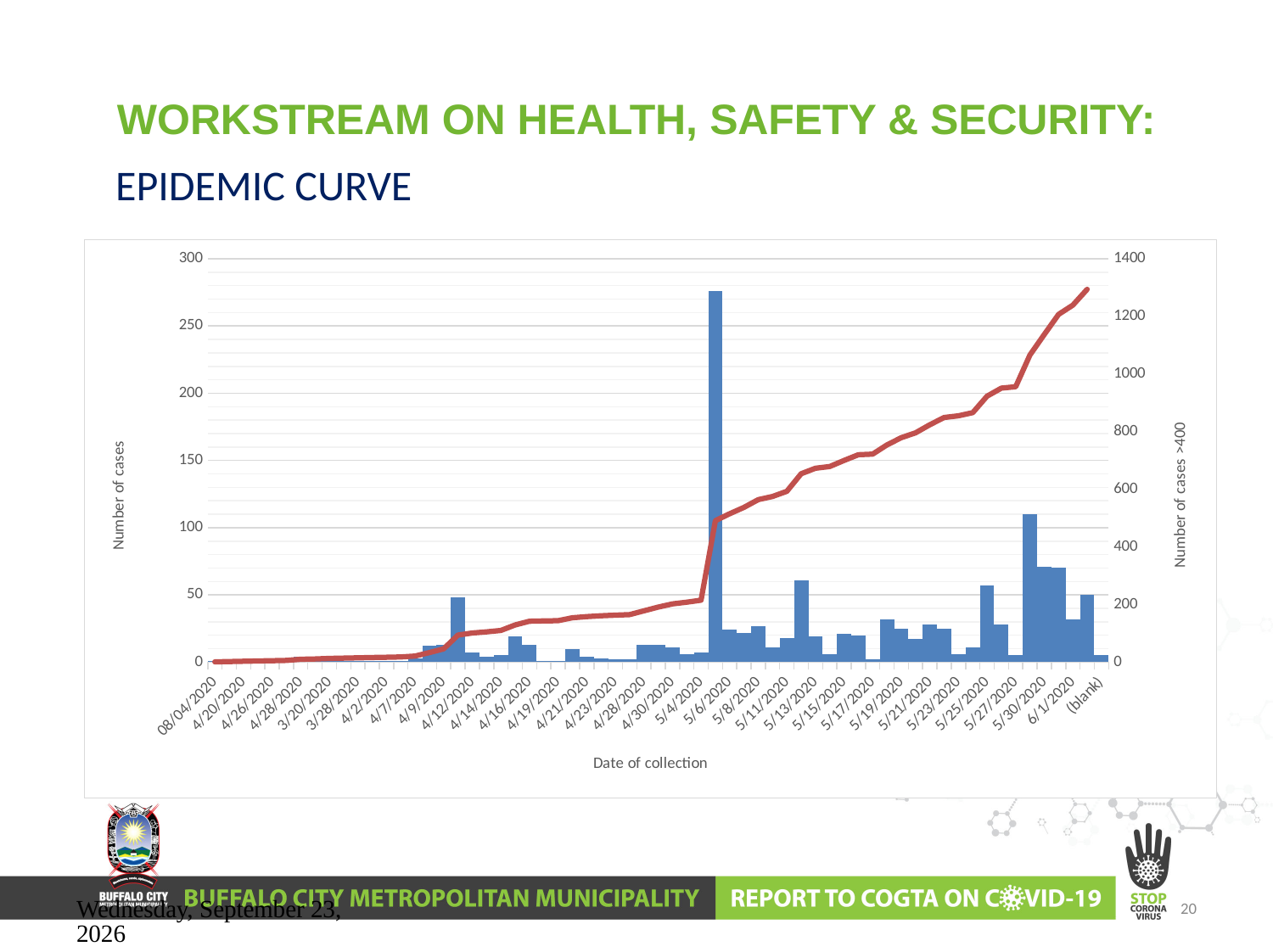
Which bar is taller, 5/30/2020 or 5/13/2020? 5/30/2020 Is the bar for 5/30/2020 greater or less than 50 on the left axis? greater What kind of chart is shown on the slide? A combined bar and line chart Is the red line value for 4/30/2020 greater or less than 400 on the right axis? less Does the red line rise or fall along the x axis from left to right? rise What is the title of the x axis of the chart? Date of collection Is the bar for 4/12/2020 greater or less than 100 on the left axis? less What is the title of the left vertical axis of the chart? Number of cases